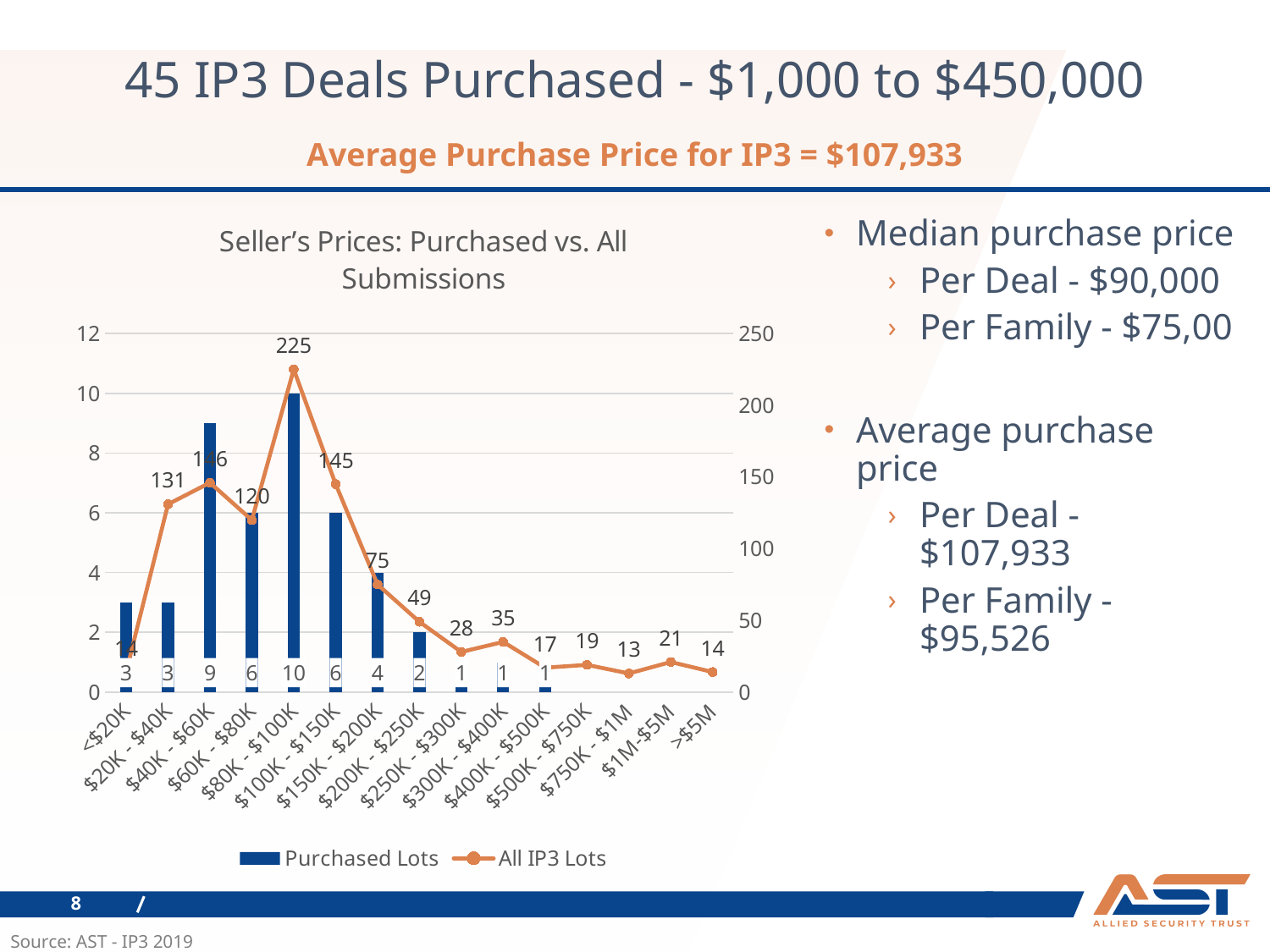
Which has more Purchased Lots: $40K - $60K or $100K - $150K? $40K - $60K What is the All IP3 Lots value for the $150K - $200K category? 75 Which price category has the highest All IP3 Lots value? $80K - $100K How many series does the legend list? 2 Do the All IP3 Lots values rise or fall from $80K - $100K to $400K - $500K? Fall What kind of chart is shown on the slide? Combined bar and line chart Which price category has the lowest All IP3 Lots value? $750K - $1M What is the title of the chart? Seller's Prices: Purchased vs. All Submissions What is the Purchased Lots value for the $80K - $100K category? 10 How many price categories are shown on the x axis? 15 What is the difference between the All IP3 Lots values for $40K - $60K and $60K - $80K? 26 What is the All IP3 Lots value for the $80K - $100K category? 225